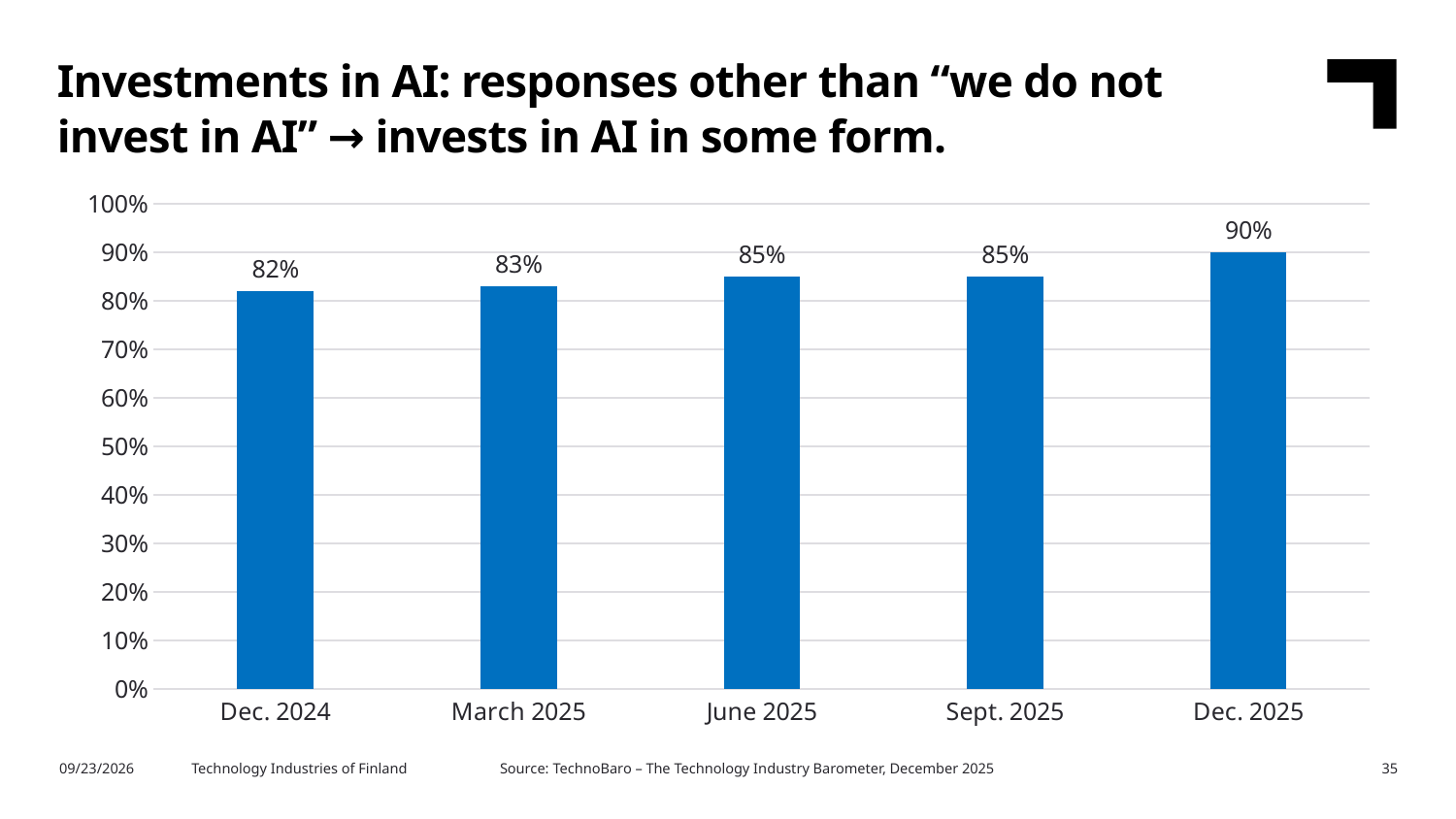
Do the values rise or fall from Dec. 2024 to Dec. 2025? rise Which period has the highest value? Dec. 2025 Which period has the lowest value? Dec. 2024 Which is larger, the value for Sept. 2025 or the value for Dec. 2025? Dec. 2025 What is the difference between the values for Dec. 2025 and Dec. 2024? 8% What is the value for Dec. 2024? 82% What is the value for June 2025? 85% What is the difference between the values for March 2025 and Dec. 2024? 1% How many periods are shown on the x axis? 5 What is the value for Dec. 2025? 90% What kind of chart is shown on the slide? bar chart Is the value for March 2025 greater or less than 90%? less